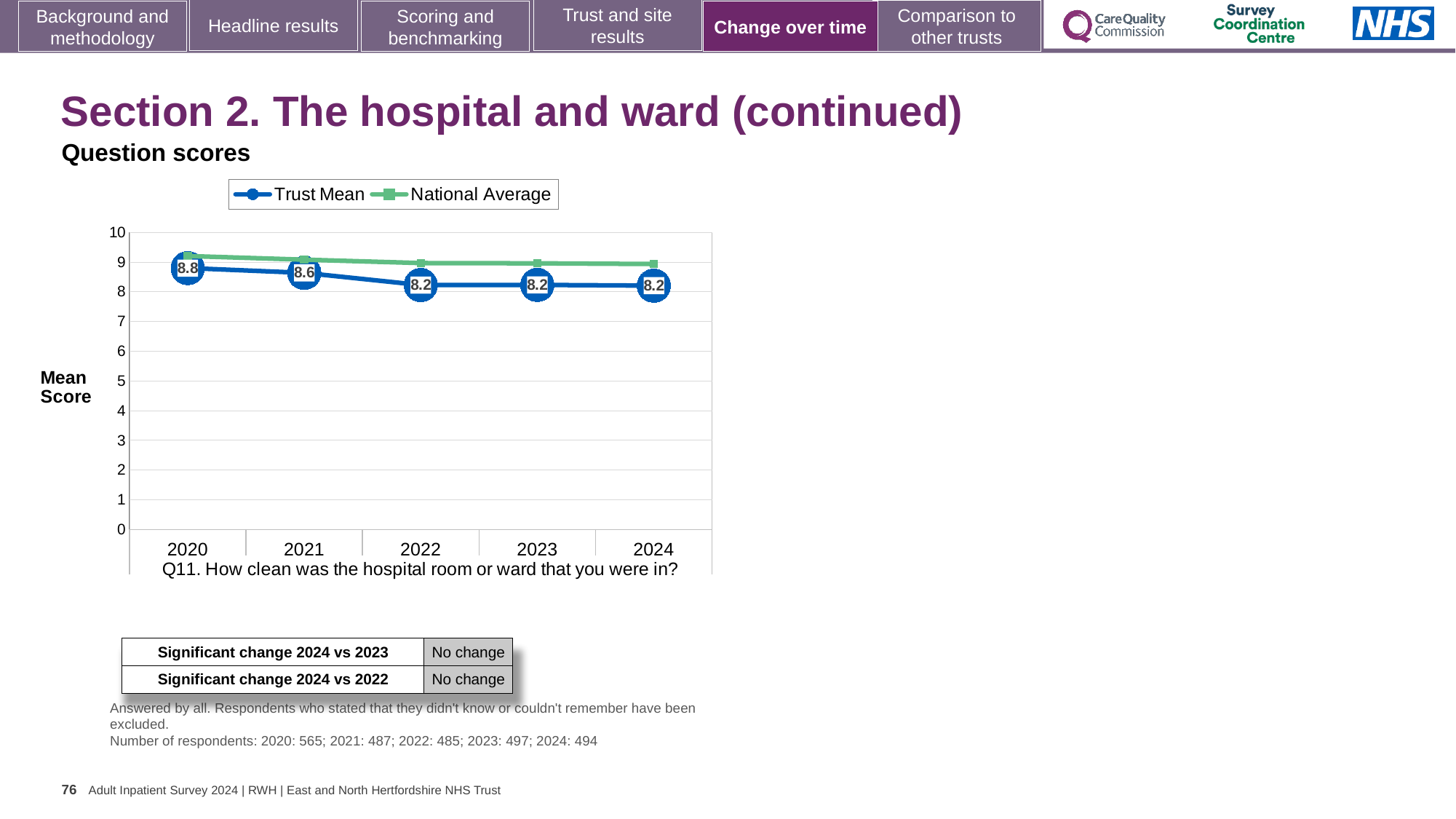
Does the Trust Mean score rise or fall from 2020 to 2024? Fall Is the National Average value for 2024 greater or less than 8? greater Which question does the chart relate to, as labelled below the x axis? Q11. How clean was the hospital room or ward that you were in? What is the Trust Mean score for 2020? 8.8 What is the Trust Mean score for 2021? 8.6 What is the difference between the Trust Mean score in 2020 and in 2024? 0.6 What is the Trust Mean score for 2024? 8.2 What kind of chart is shown? Line chart In which year is the Trust Mean score highest? 2020 How many series does the legend list? 2 How many years are shown on the x axis? 5 Which is larger, the Trust Mean score in 2021 or in 2022? 2021